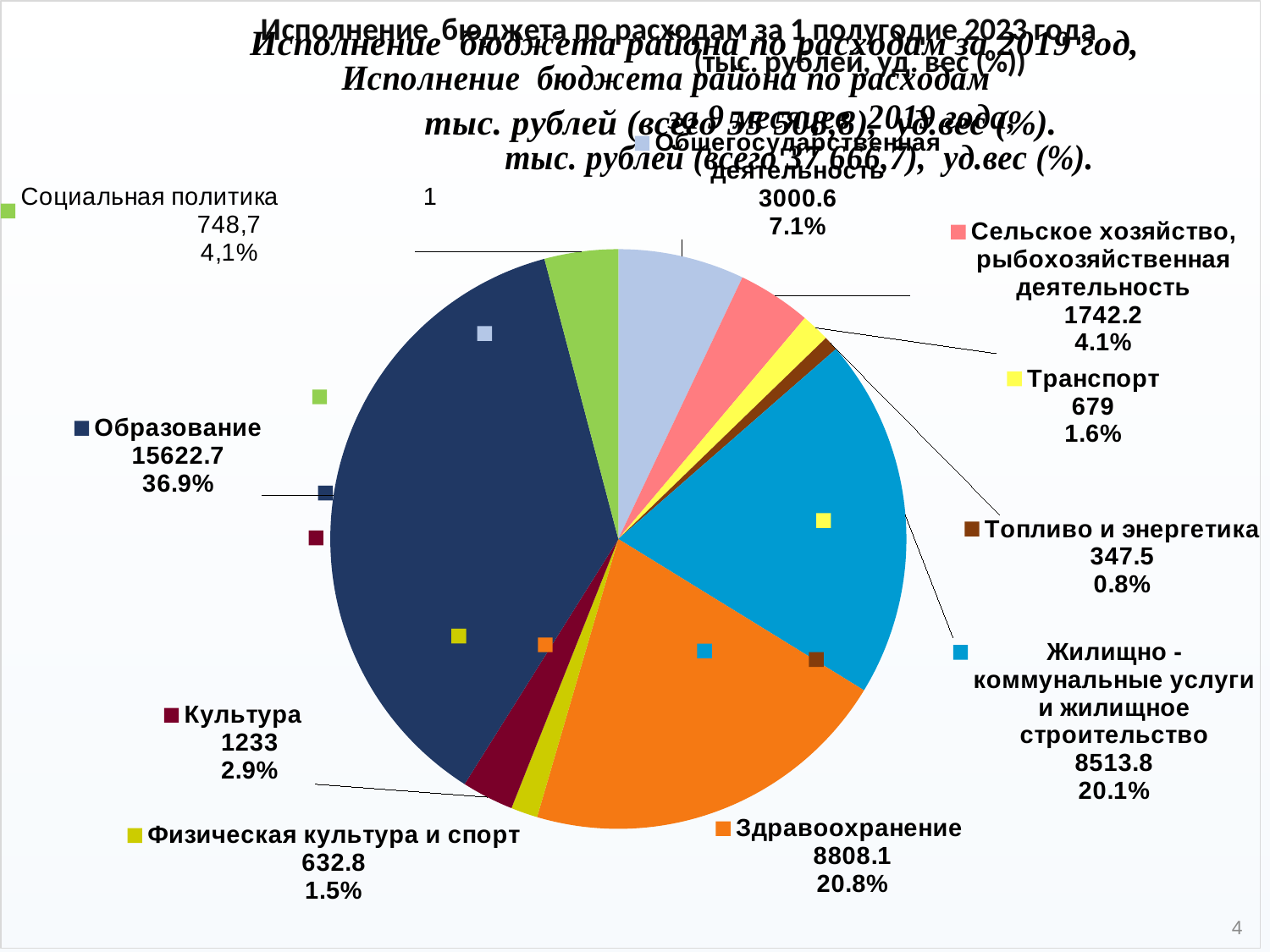
What kind of chart is shown on the slide? pie chart Which category has the smallest slice of the pie? Топливо и энергетика What share of the pie does Образование represent? 36.9% What value is shown for Образование? 15622.7 What share of the pie does Топливо и энергетика represent? 0.8% What share of the pie does Жилищно-коммунальные услуги и жилищное строительство represent? 20.1% What value is shown for Здравоохранение? 8808.1 Which is larger, the value for Культура or the value for Физическая культура и спорт? Культура What value is shown for Транспорт? 679 Which category has the largest slice of the pie? Образование What is the difference between the values for Здравоохранение and Жилищно-коммунальные услуги и жилищное строительство? 294.3 How many categories are shown in the pie chart? 10